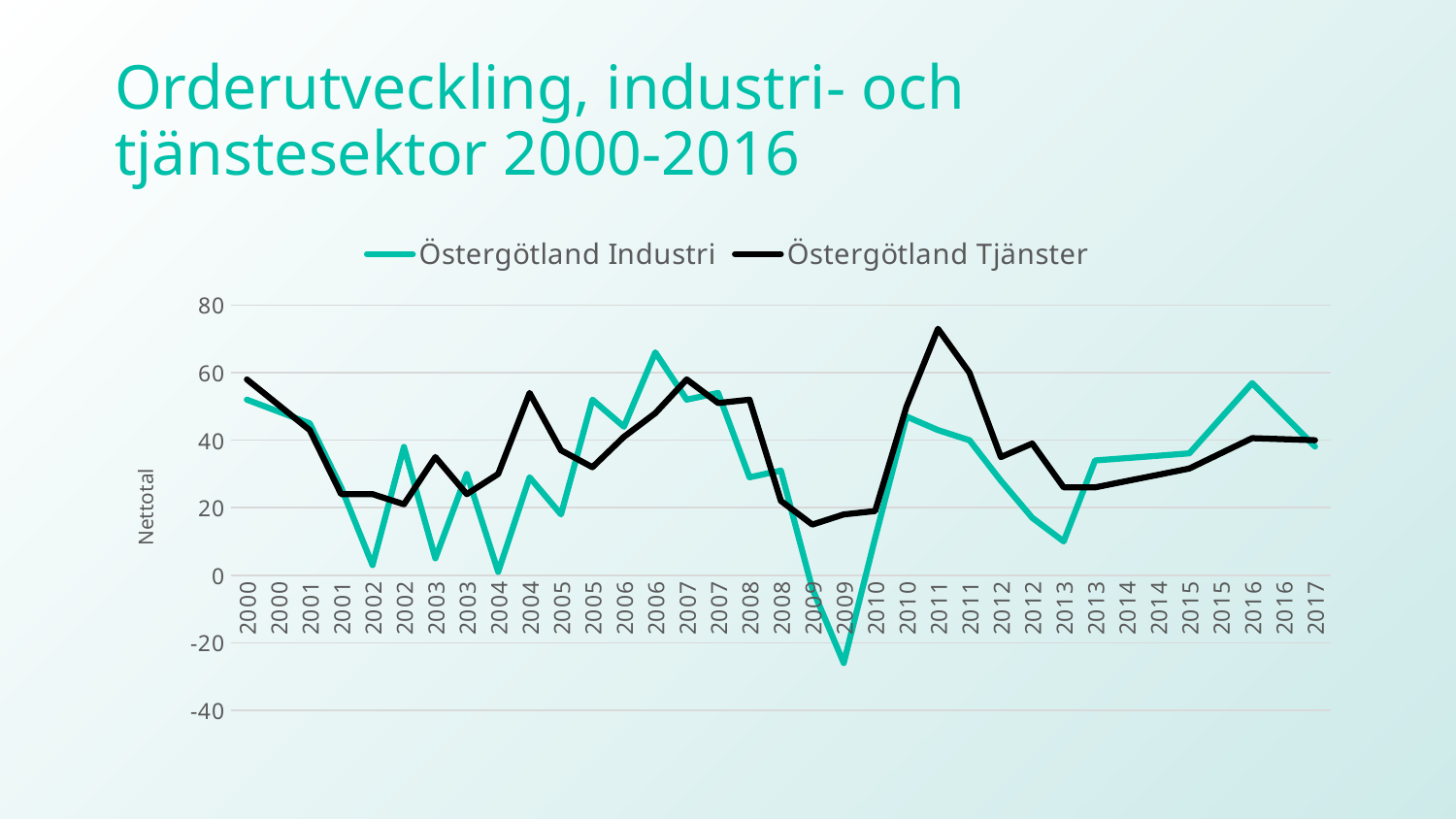
Is the value for Östergötland Industri at the first 2013 point greater or less than 20? less Is the value for Östergötland Tjänster at the first 2009 point greater or less than 20? less Is the value for Östergötland Industri at the second 2009 point greater or less than -20? less At the first 2011 point, which series has the larger value, Östergötland Industri or Östergötland Tjänster? Östergötland Tjänster What are the two series named in the legend? Östergötland Industri and Östergötland Tjänster In which year does Östergötland Industri reach its lowest value? 2009 What kind of chart is shown on the slide? Line chart How many series does the legend list? 2 What is the label on the vertical axis? Nettotal In which year does Östergötland Tjänster reach its highest value? 2011